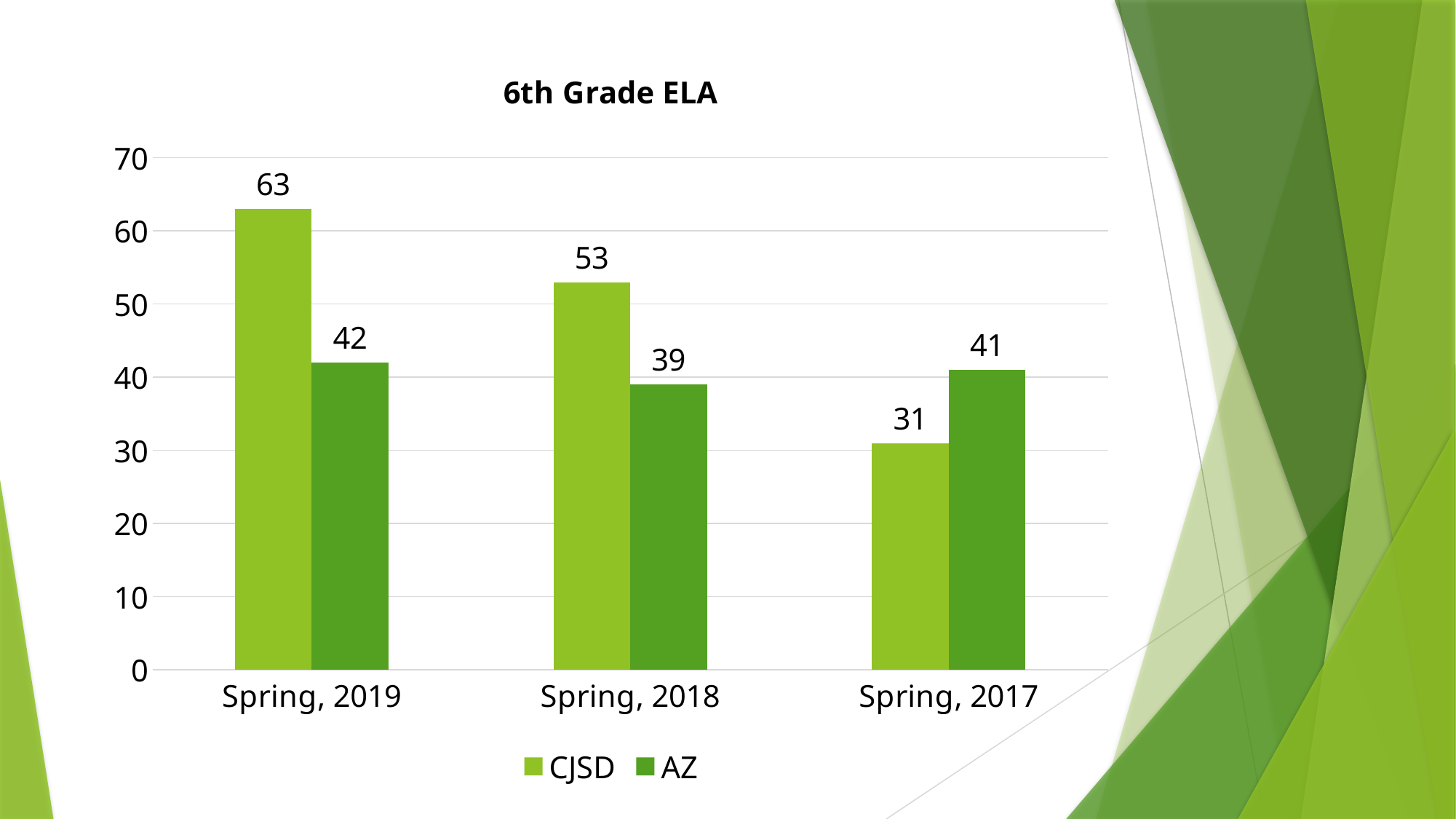
What is the AZ value for Spring, 2018? 39 Is the AZ value for Spring, 2019 greater or less than 50? less What is the CJSD value for Spring, 2017? 31 What is the CJSD value for Spring, 2019? 63 How many series does the legend list? 2 Which category has the highest CJSD value? Spring, 2019 What kind of chart is shown? bar chart Which is larger for Spring, 2017, CJSD or AZ? AZ Which category has the lowest AZ value? Spring, 2018 How many categories are shown on the x axis? 3 What is the title of the chart? 6th Grade ELA What is the difference between the CJSD and AZ values for Spring, 2019? 21